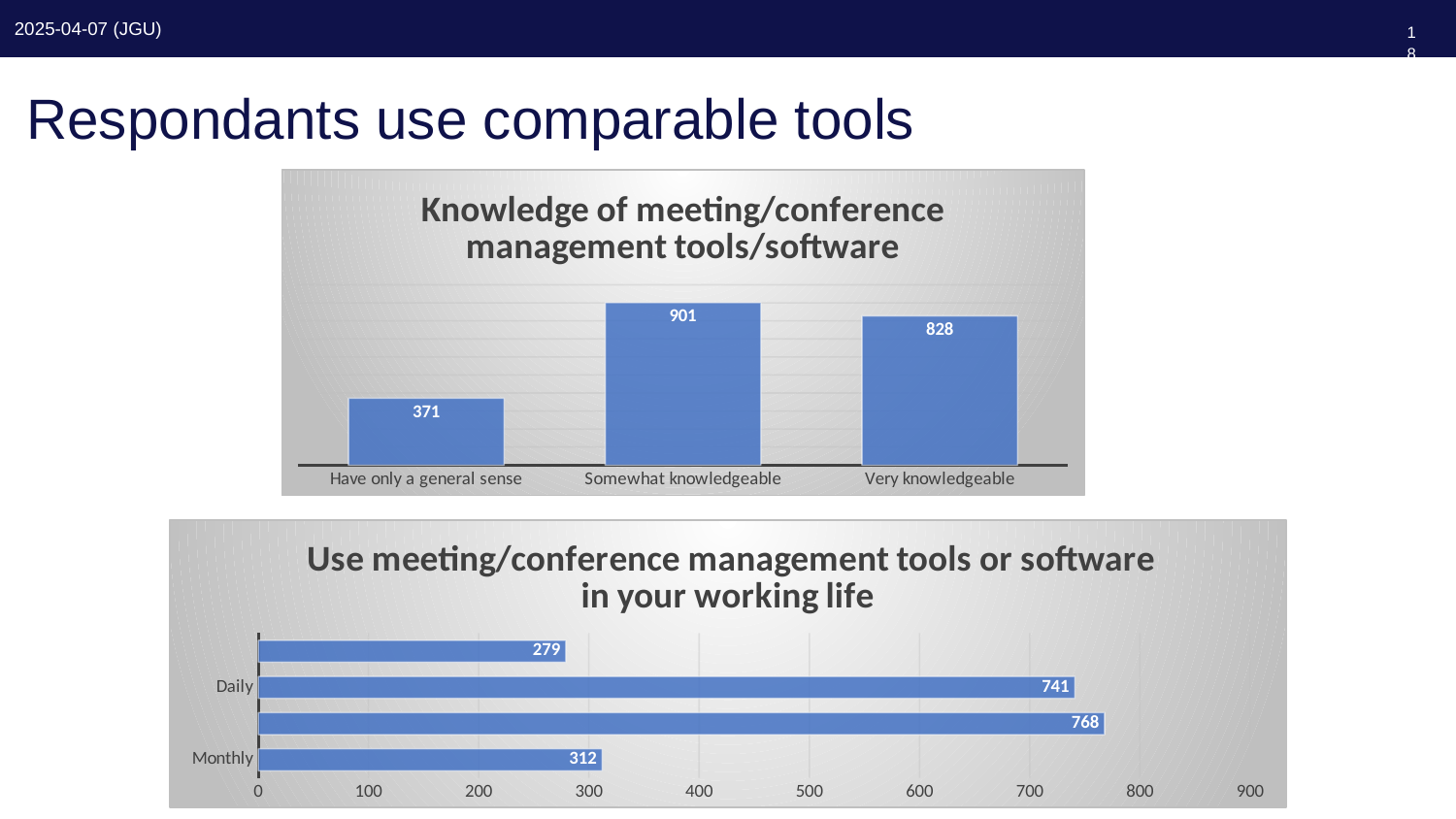
In the 'Use meeting/conference management tools or software in your working life' chart, what is the value for 'Monthly'? 312 In the 'Knowledge of meeting/conference management tools/software' chart, which category has the highest value? Somewhat knowledgeable What type of chart is the 'Use meeting/conference management tools or software in your working life' chart? Bar chart In the 'Knowledge of meeting/conference management tools/software' chart, which category has the lowest value? Have only a general sense In the 'Knowledge of meeting/conference management tools/software' chart, what is the difference between 'Somewhat knowledgeable' and 'Very knowledgeable'? 73 In the 'Use meeting/conference management tools or software in your working life' chart, how many bars are shown? 4 In the 'Knowledge of meeting/conference management tools/software' chart, what is the value for 'Somewhat knowledgeable'? 901 In the 'Use meeting/conference management tools or software in your working life' chart, what is the value for 'Daily'? 741 In the 'Knowledge of meeting/conference management tools/software' chart, how many categories are shown? 3 In the 'Knowledge of meeting/conference management tools/software' chart, what is the value for 'Have only a general sense'? 371 In the 'Use meeting/conference management tools or software in your working life' chart, what is the difference between 'Daily' and 'Monthly'? 429 In the 'Use meeting/conference management tools or software in your working life' chart, which is larger, 'Daily' or 'Monthly'? Daily